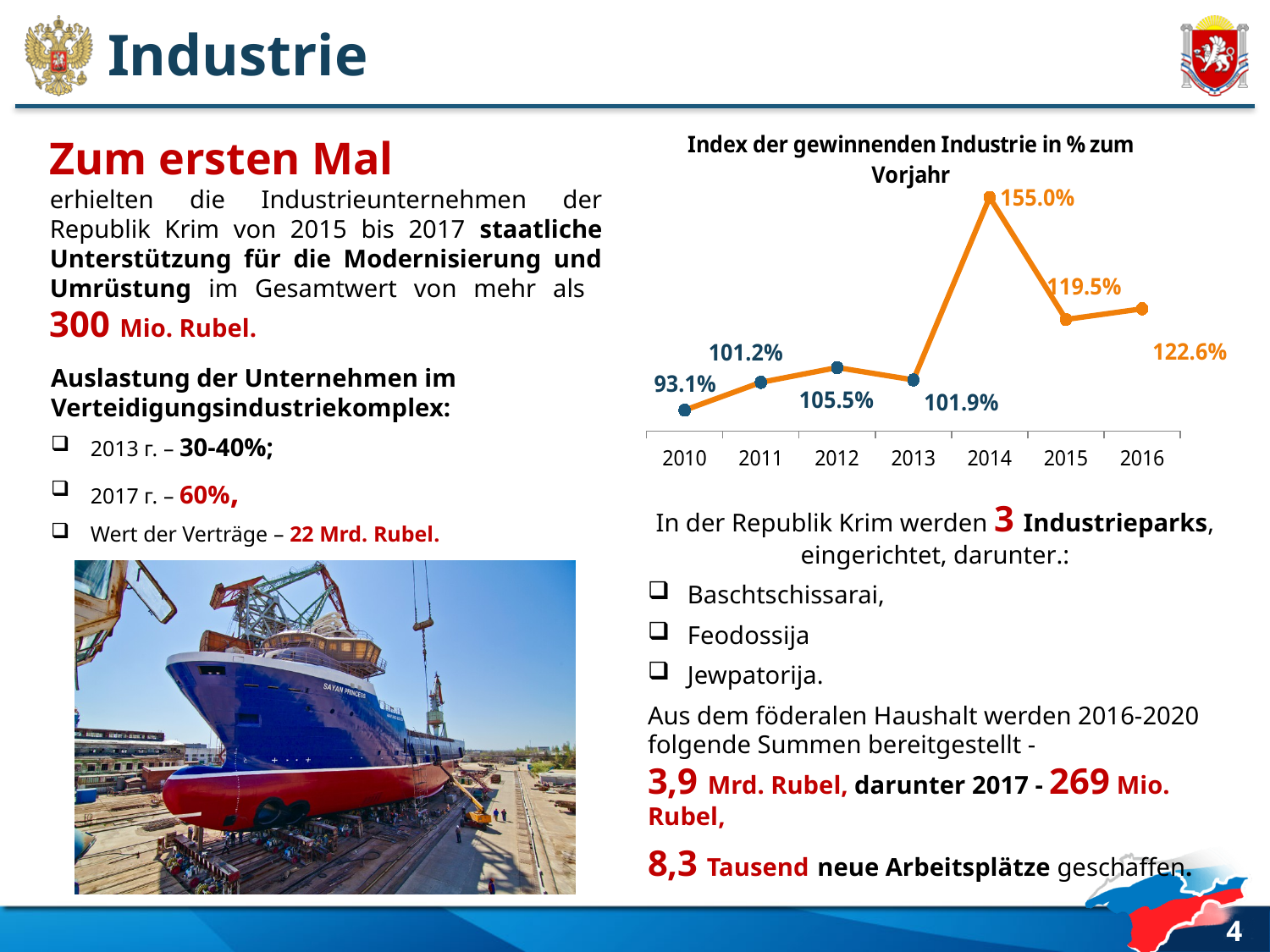
Which is larger, the value for 2013 or the value for 2011? 2013 How many years are plotted in the chart? 7 Which year has the highest value in the chart? 2014 What is the difference between the values for 2014 and 2015? 35.5% What is the value for 2012 in the chart? 105.5% What is the value for 2010 in the chart? 93.1% What is the value for 2014 in the chart? 155.0% Which year has the lowest value in the chart? 2010 What is the value for 2016 in the chart? 122.6% What is the title of the chart? Index der gewinnenden Industrie in % zum Vorjahr Does the value rise or fall from 2014 to 2015? fall What type of chart is shown on the slide? line chart